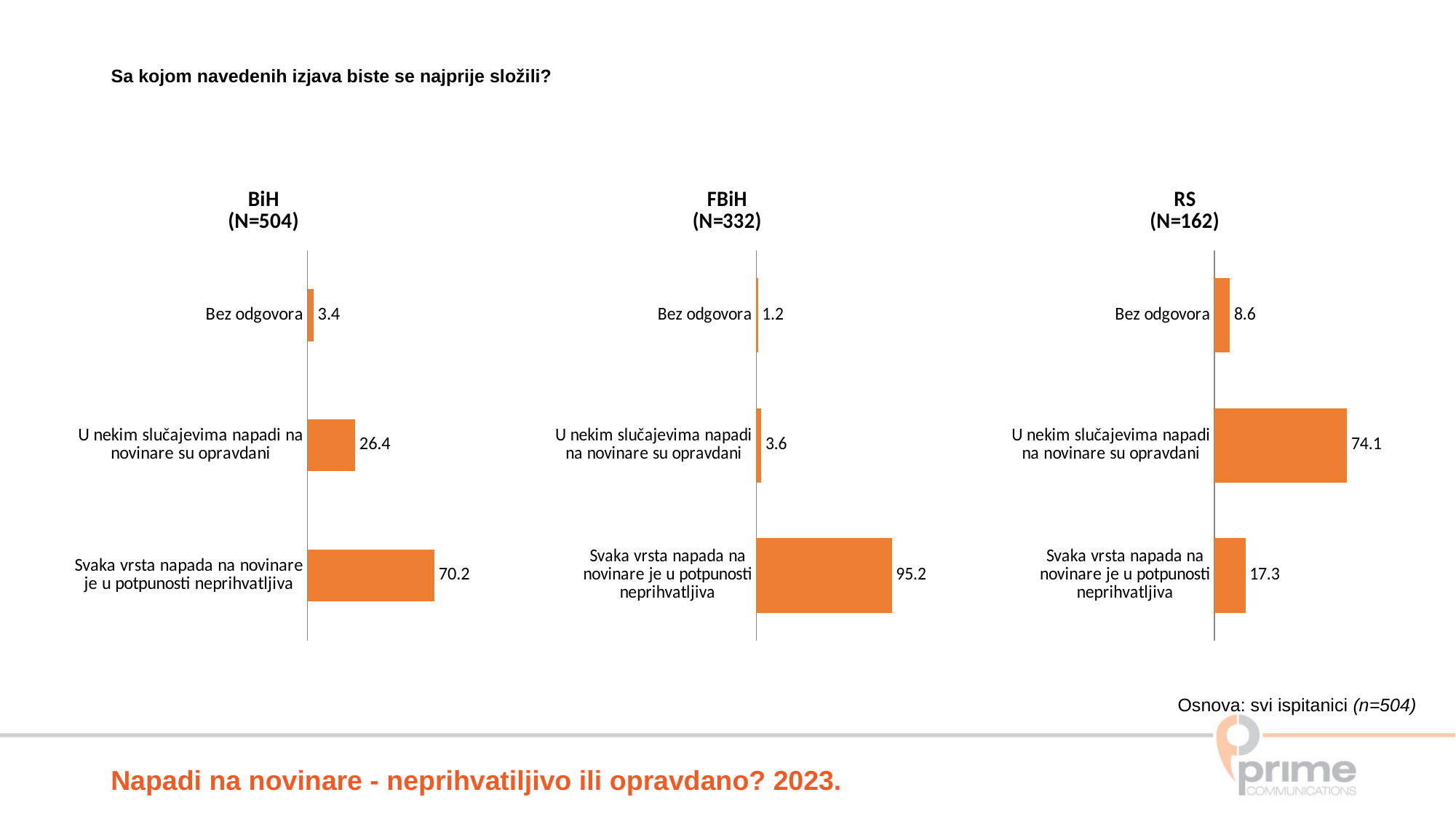
In the FBiH (N=332) chart, which category has the lowest value? Bez odgovora In the RS (N=162) chart, what is the value for "Bez odgovora"? 8.6 What kind of chart is the FBiH (N=332) chart? Bar chart In the RS (N=162) chart, what is the difference between the values for "U nekim slučajevima napadi na novinare su opravdani" and "Svaka vrsta napada na novinare je u potpunosti neprihvatljiva"? 56.8 In the RS (N=162) chart, which category has the highest value? U nekim slučajevima napadi na novinare su opravdani In the FBiH (N=332) chart, what is the value for "U nekim slučajevima napadi na novinare su opravdani"? 3.6 In the BiH (N=504) chart, what is the value for "Svaka vrsta napada na novinare je u potpunosti neprihvatljiva"? 70.2 In the BiH (N=504) chart, what is the difference between the values for "Svaka vrsta napada na novinare je u potpunosti neprihvatljiva" and "U nekim slučajevima napadi na novinare su opravdani"? 43.8 How many charts are shown on the slide? 3 What is the sample size (N) shown in the title of the RS chart? N=162 Which is larger: the value for "Svaka vrsta napada na novinare je u potpunosti neprihvatljiva" in the FBiH (N=332) chart or in the RS (N=162) chart? FBiH (N=332) How many categories are shown in the BiH (N=504) chart? 3